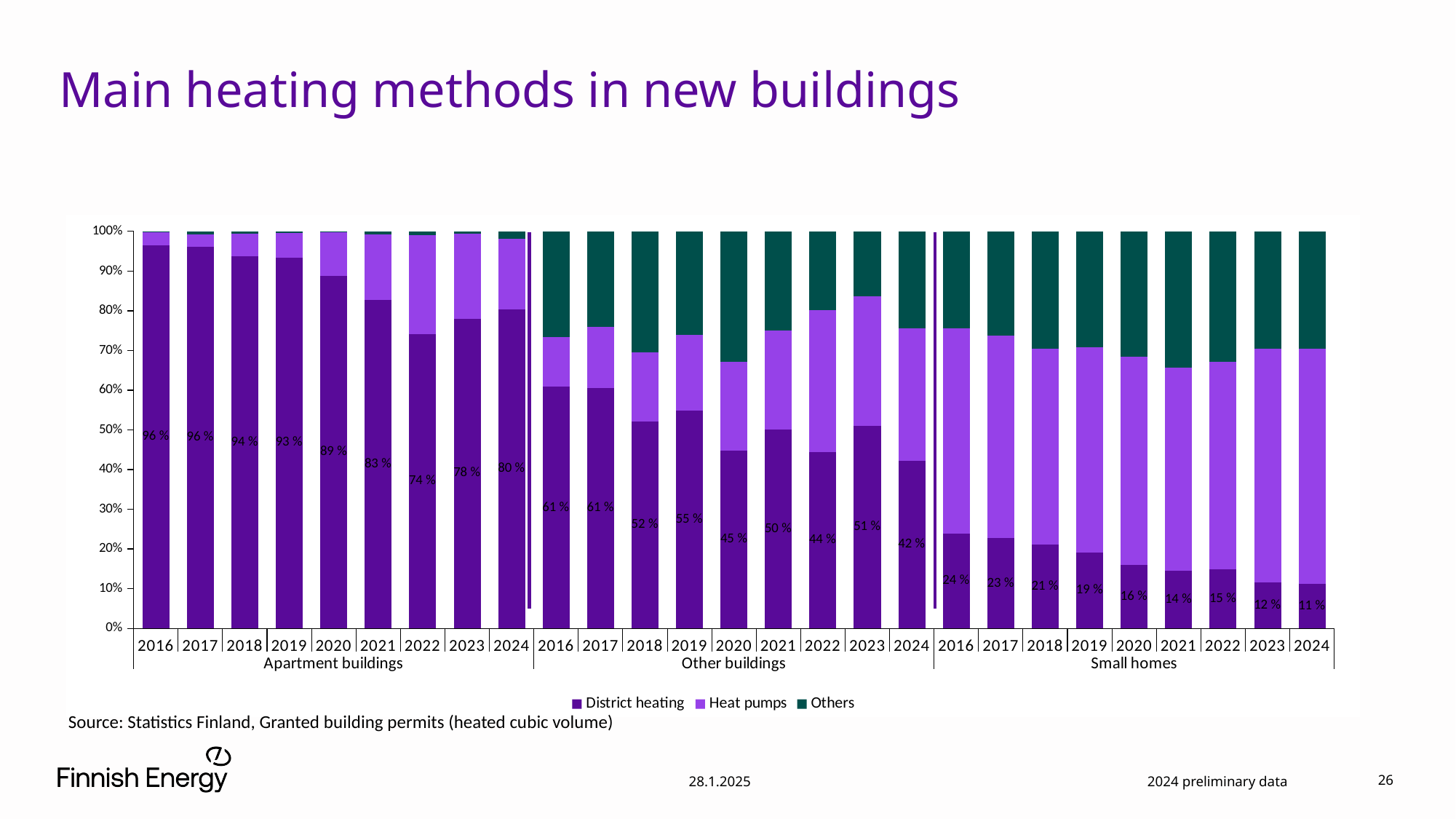
How many years are shown for each building category? 9 Does the district heating share for Apartment buildings generally rise or fall from 2016 to 2024? Fall What is the district heating share for Small homes in 2024? 11 % What is the district heating share for Other buildings in 2020? 45 % Within the Apartment buildings group, which year has the lowest district heating share? 2022 Within the Small homes group, which year has the highest district heating share? 2016 What is the district heating share for Apartment buildings in 2016? 96 % What kind of chart is shown on the slide? Stacked bar chart How many series does the legend list? 3 Is the district heating share for Small homes in 2020 greater or less than 20%? less Which has the larger district heating share: Other buildings in 2019 or Other buildings in 2023? Other buildings in 2019 By how many percentage points did the district heating share for Apartment buildings fall from 2016 to 2024? 16 percentage points